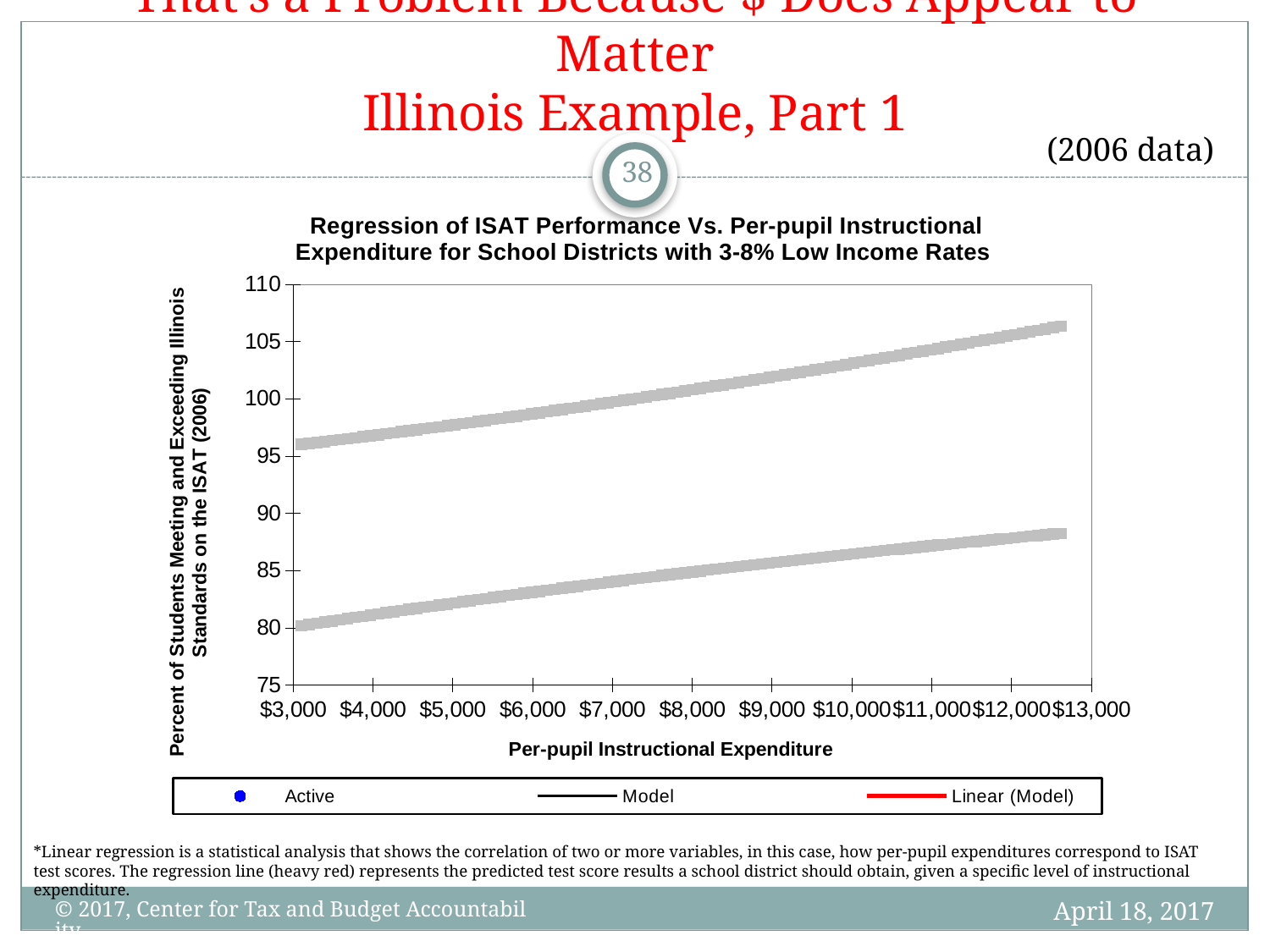
Is the value of the upper line at $3,000 greater or less than 100? less What are the three entries listed in the legend? Active, Model, Linear (Model) How many series does the legend list? 3 What kind of chart is shown on the slide? line chart Do the plotted lines rise or fall as per-pupil instructional expenditure increases? rise Is the value of the lower line at $13,000 greater or less than 90? less How many lines are plotted on the chart? 2 Is the value of the upper line at $13,000 greater or less than 100? greater What is the label of the x axis? Per-pupil Instructional Expenditure